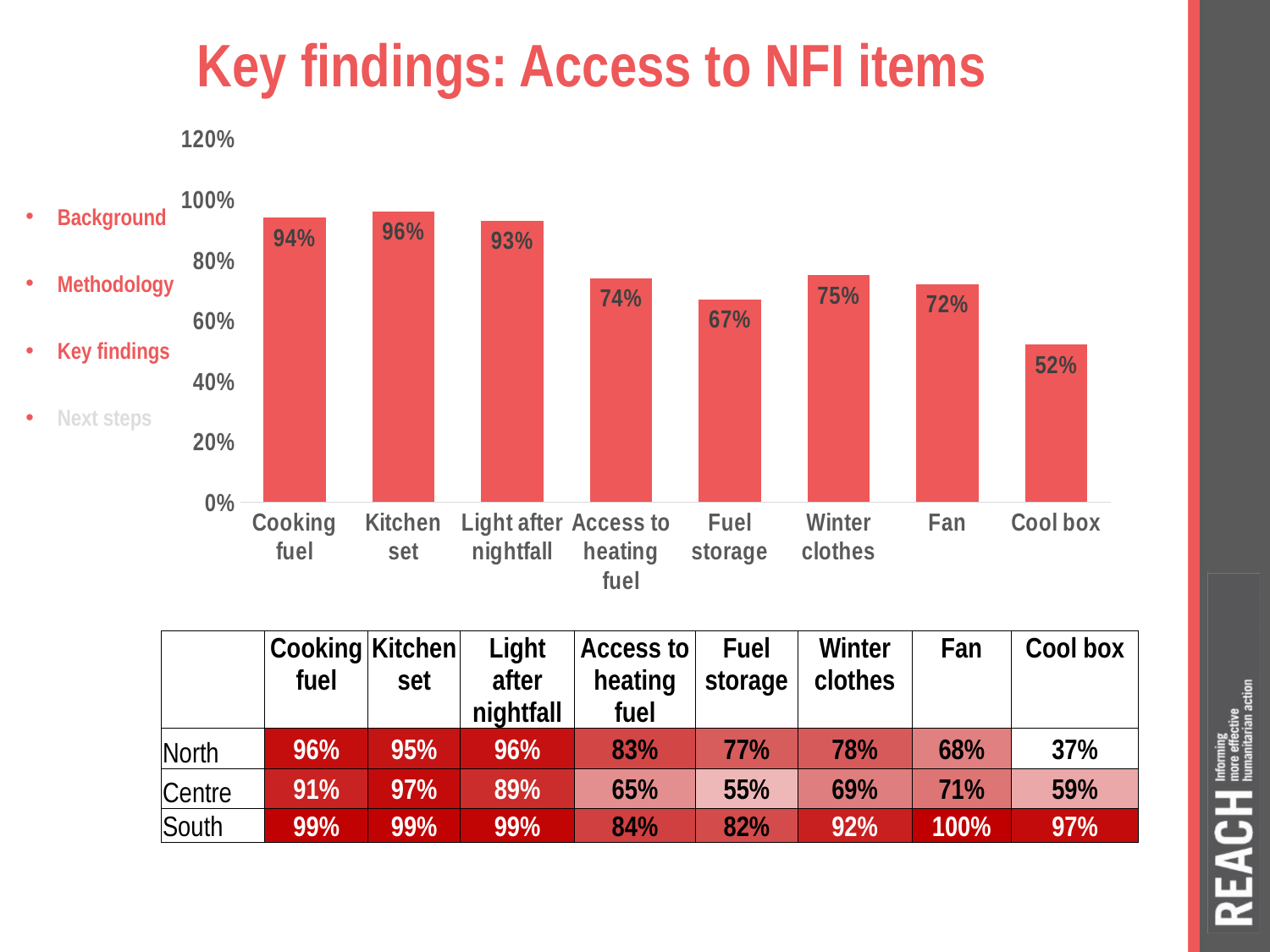
What kind of chart is shown on the slide? bar chart Is the value for Access to heating fuel greater or less than 80%? less How many categories are shown on the x axis? 8 Which category has the highest value? Kitchen set What is the difference between the values for Light after nightfall and Access to heating fuel? 19% What is the value for Cool box? 52% What is the highest tick value shown on the y axis? 120% Which category has the lowest value? Cool box What is the value for Cooking fuel? 94% What is the value for Fuel storage? 67% Which is larger, the value for Winter clothes or the value for Fan? Winter clothes What is the difference between the values for Kitchen set and Cool box? 44%